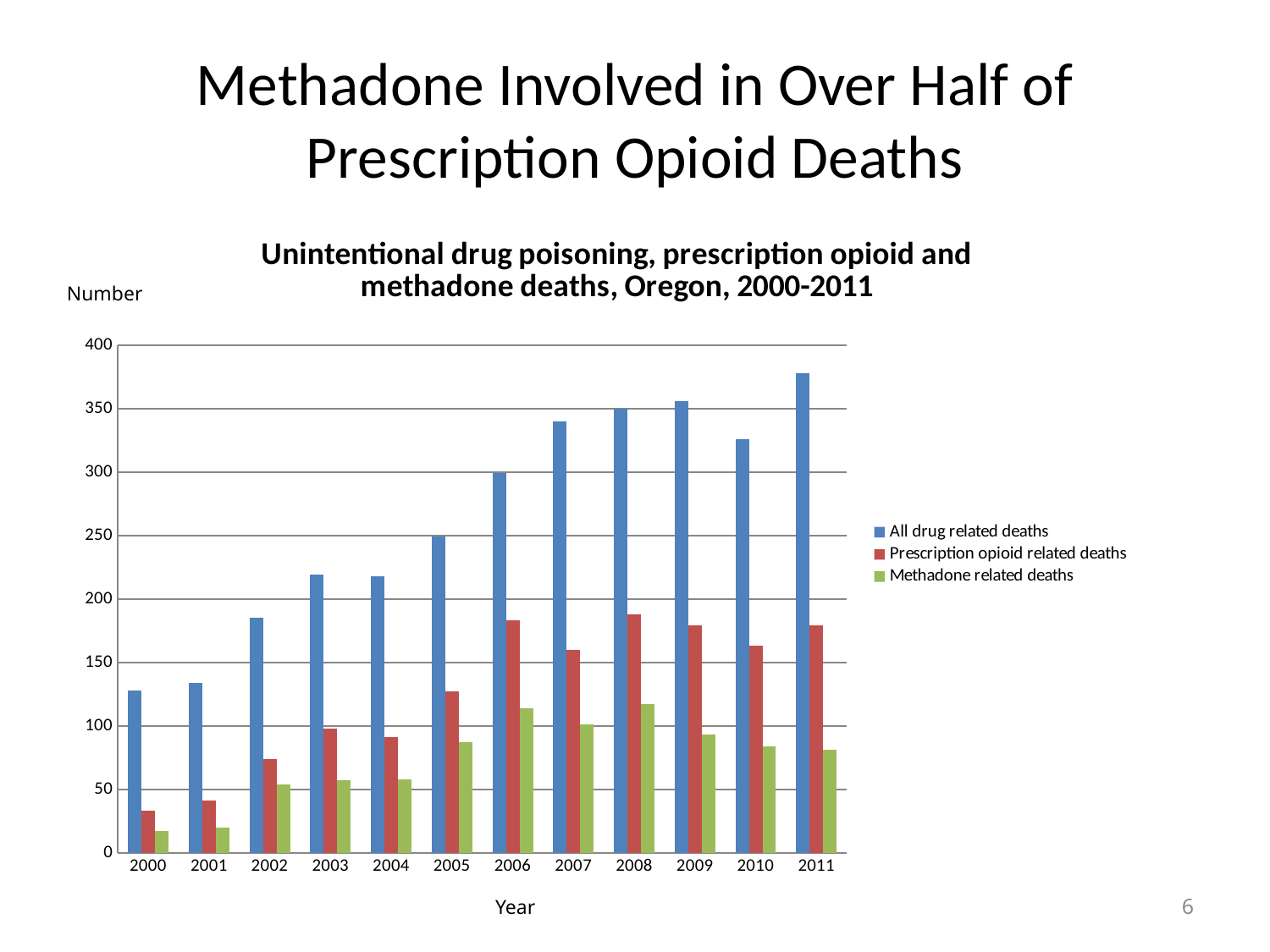
Which colour represents Methadone related deaths in the legend? green How many series does the legend list? 3 Which is larger, All drug related deaths in 2009 or in 2010? 2009 Which is larger, Prescription opioid related deaths in 2005 or in 2007? 2007 Is the value for Methadone related deaths in 2000 greater or less than 50? less Do the values for All drug related deaths generally rise or fall from 2000 to 2008? rise In which year is the value for All drug related deaths highest? 2011 Is the value for All drug related deaths in 2011 greater or less than 350? greater Is the value for Methadone related deaths in 2011 greater or less than 100? less How many years are shown on the x axis? 12 What kind of chart is shown on the slide? bar chart